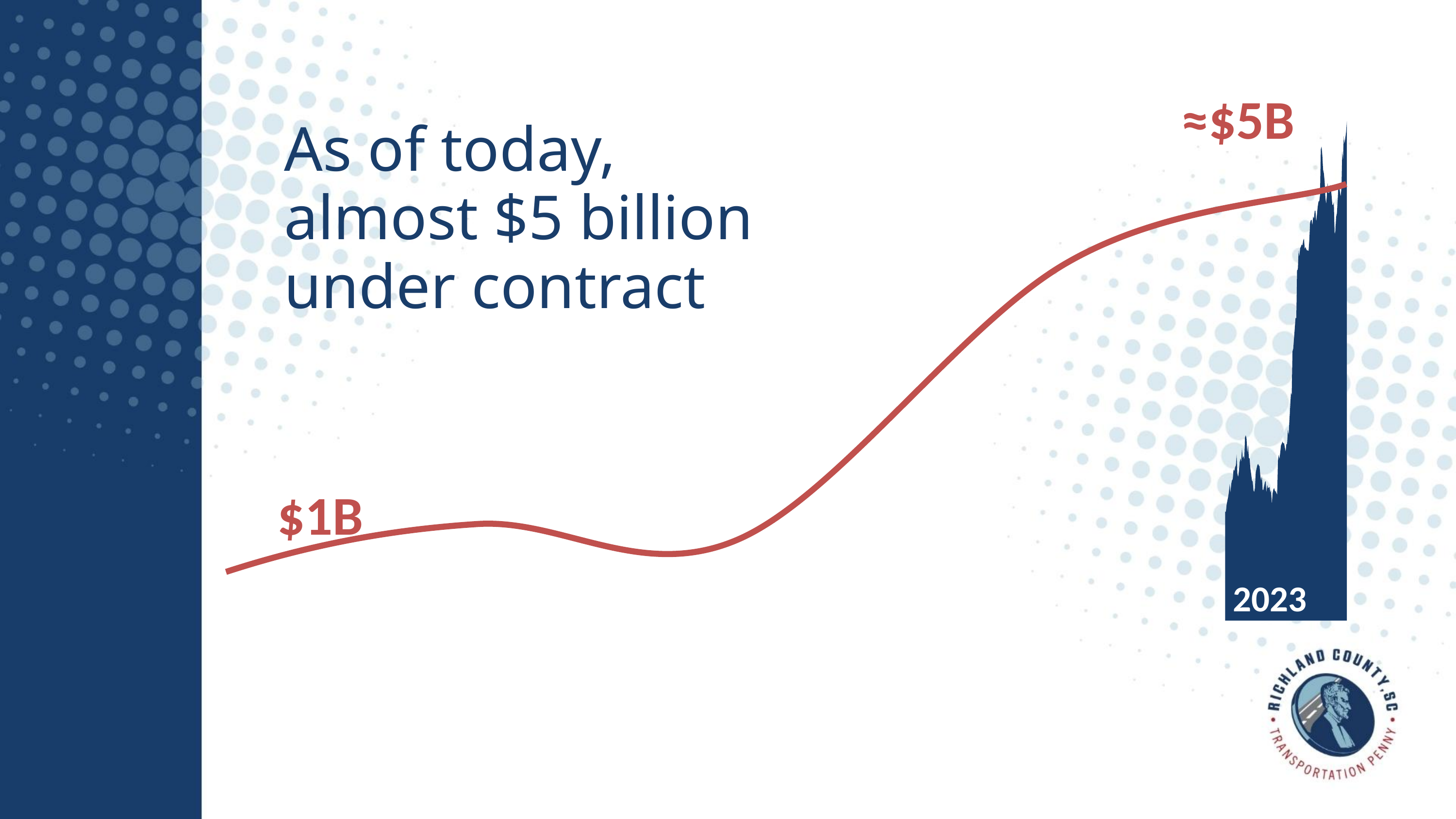
How many lines are plotted on the chart? 1 What year is labelled at the right end of the chart? 2023 Does the red line rise or fall from left to right? rise What colour is the line plotted on the chart? red What kind of chart is shown on the slide? area chart Which is larger, the value at the start of the line or the value at the end of the line? the end of the line What value label is printed at the end of the red line? ≈$5B What value label is printed at the start of the red line? $1B